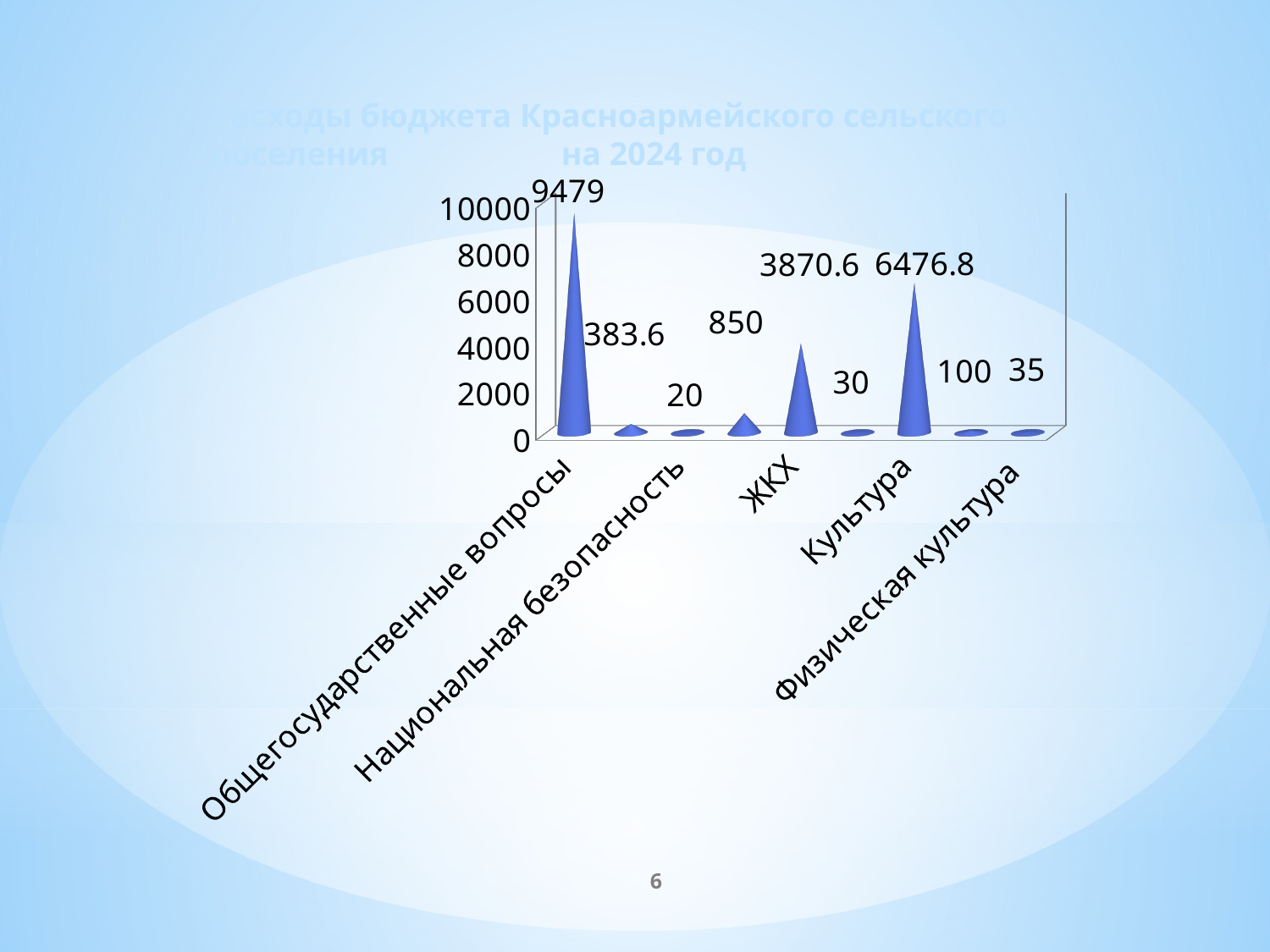
Is the value for Общегосударственные вопросы greater or less than 8000? greater Which category has the highest value? Общегосударственные вопросы Which is larger, the value for Культура or the value for ЖКХ? Культура What is the largest data label shown on the chart? 9479 What is the value for Культура? 6476.8 What is the value for Общегосударственные вопросы? 9479 What is the value for ЖКХ? 3870.6 What is the difference between the values for Культура and ЖКХ? 2606.2 What is the smallest data label shown on the chart? 20 What is the value for Физическая культура? 35 How many data points are plotted on the chart? 9 What kind of chart is shown on the slide? bar chart